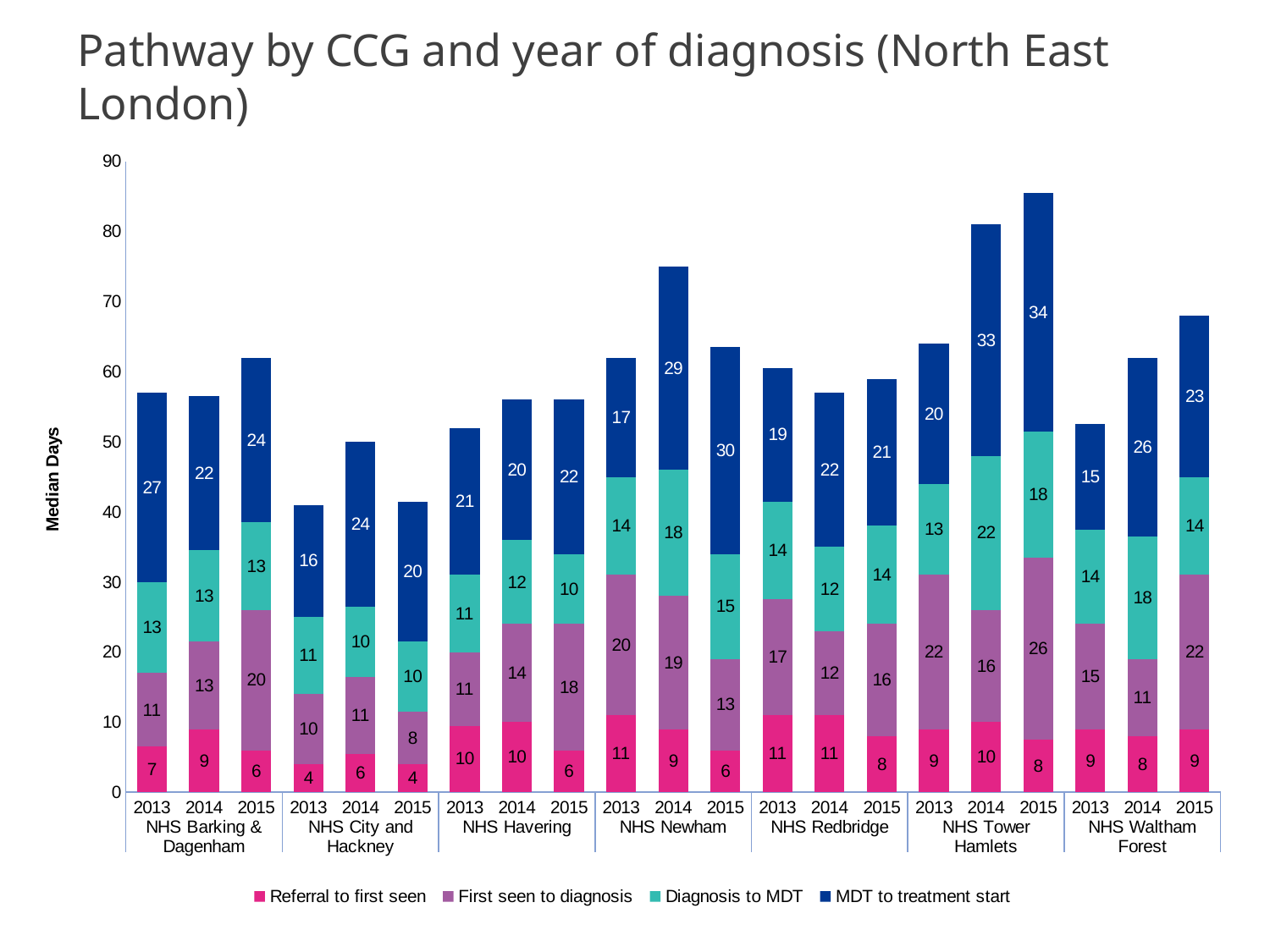
How many series does the legend list? 4 Is the total stacked bar for NHS City and Hackney in 2014 greater or less than 60? less What is the 'First seen to diagnosis' value for NHS Newham in 2013? 20 What type of chart is shown on the slide? Stacked bar chart What is the 'Referral to first seen' value for NHS City and Hackney in 2013? 4 What is the total of the stacked bar for NHS Newham in 2014? 75 Which CCG and year has the tallest stacked bar overall? NHS Tower Hamlets 2015 How many CCGs are shown on the x axis? 7 Which is larger: the 'First seen to diagnosis' value for NHS Tower Hamlets in 2015 or for NHS Redbridge in 2015? NHS Tower Hamlets 2015 What is the difference between the 'MDT to treatment start' values for NHS Newham in 2014 and 2013? 12 What is the 'Diagnosis to MDT' value for NHS Waltham Forest in 2014? 18 What is the 'MDT to treatment start' value for NHS Tower Hamlets in 2015? 34